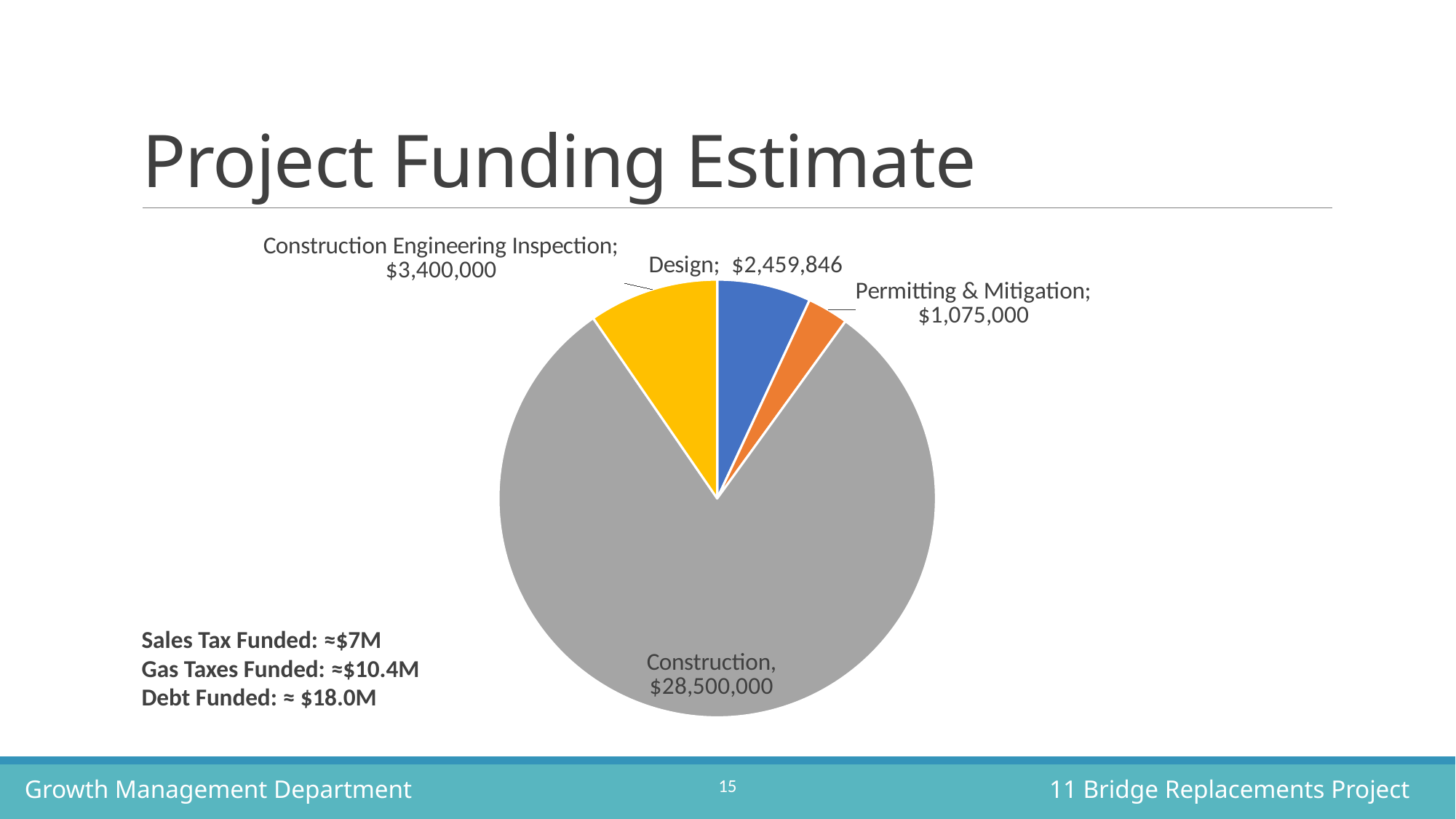
Which category has the smallest slice of the pie? Permitting & Mitigation What is the value of the Design slice? $2,459,846 How many slices does the pie chart have? 4 What is the value for Permitting & Mitigation? $1,075,000 What is the title of the slide containing the chart? Project Funding Estimate What is the difference between the Construction and Construction Engineering Inspection values? $25,100,000 Which is larger, the Design value or the Permitting & Mitigation value? Design What type of chart is shown on the slide? Pie chart What is the total of all four slices in the pie chart? $35,434,846 Which category has the largest slice of the pie? Construction What is the value for Construction Engineering Inspection? $3,400,000 What is the value of the Construction slice? $28,500,000